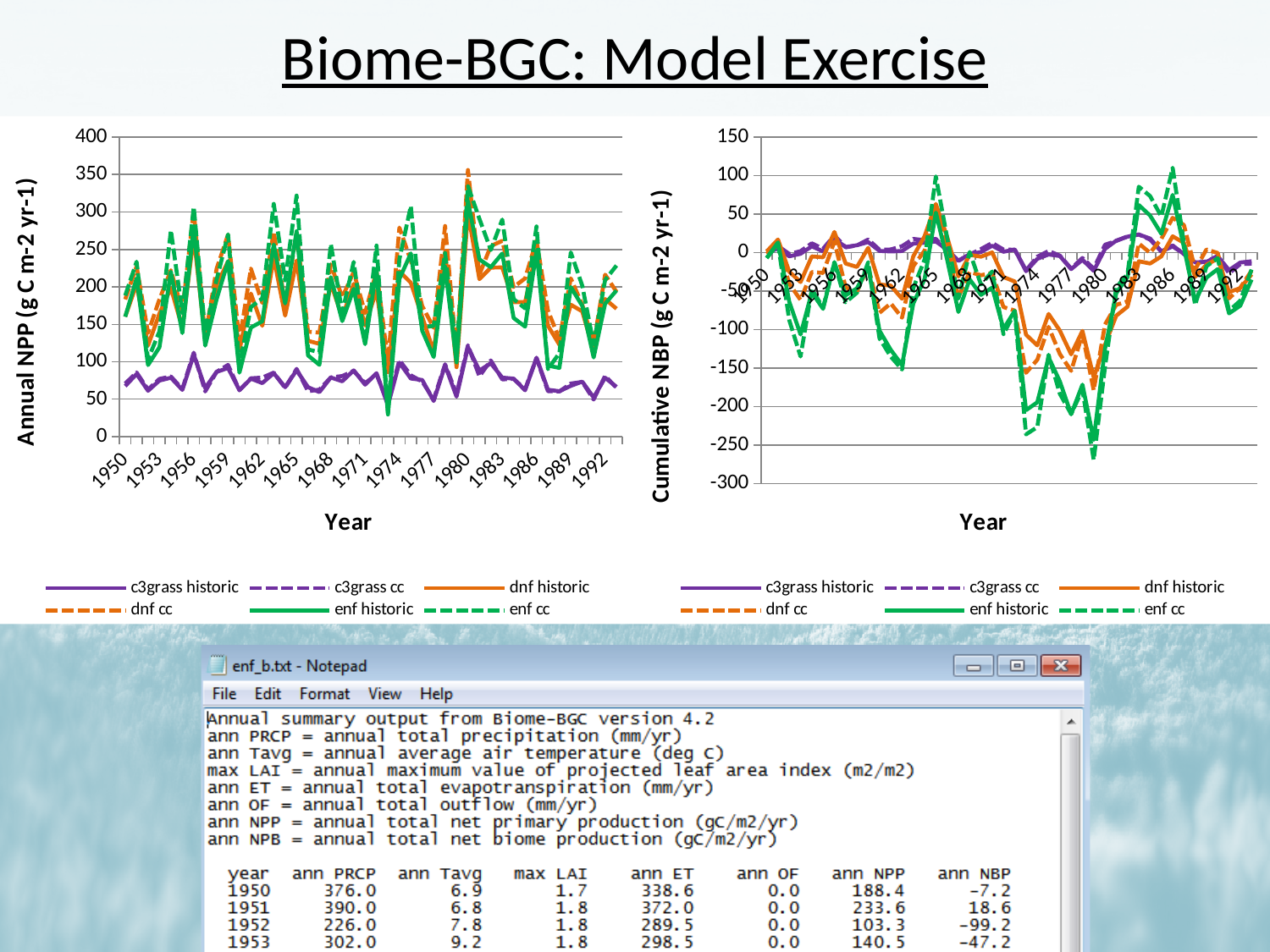
What kind of chart is the Cumulative NBP chart on the right? line chart In the Cumulative NBP chart, is the value for c3grass historic in 1983 greater or less than -50? greater What is the y-axis title of the chart on the right? Cumulative NBP (g C m-2 yr-1) In the Cumulative NBP chart, is the value for enf historic in 1981 greater or less than -200? greater What is the y-axis title of the chart on the left? Annual NPP (g C m-2 yr-1) In the Cumulative NBP chart, which is higher in 1974, c3grass historic or enf historic? c3grass historic In the Annual NPP chart, is the value for c3grass historic in 1980 greater or less than 150? less How many series does the legend of the Cumulative NBP chart list? 6 How many series does the legend of the Annual NPP chart list? 6 What kind of chart is the Annual NPP chart on the left? line chart In the Annual NPP chart, which is higher in 1956, c3grass historic or enf historic? enf historic